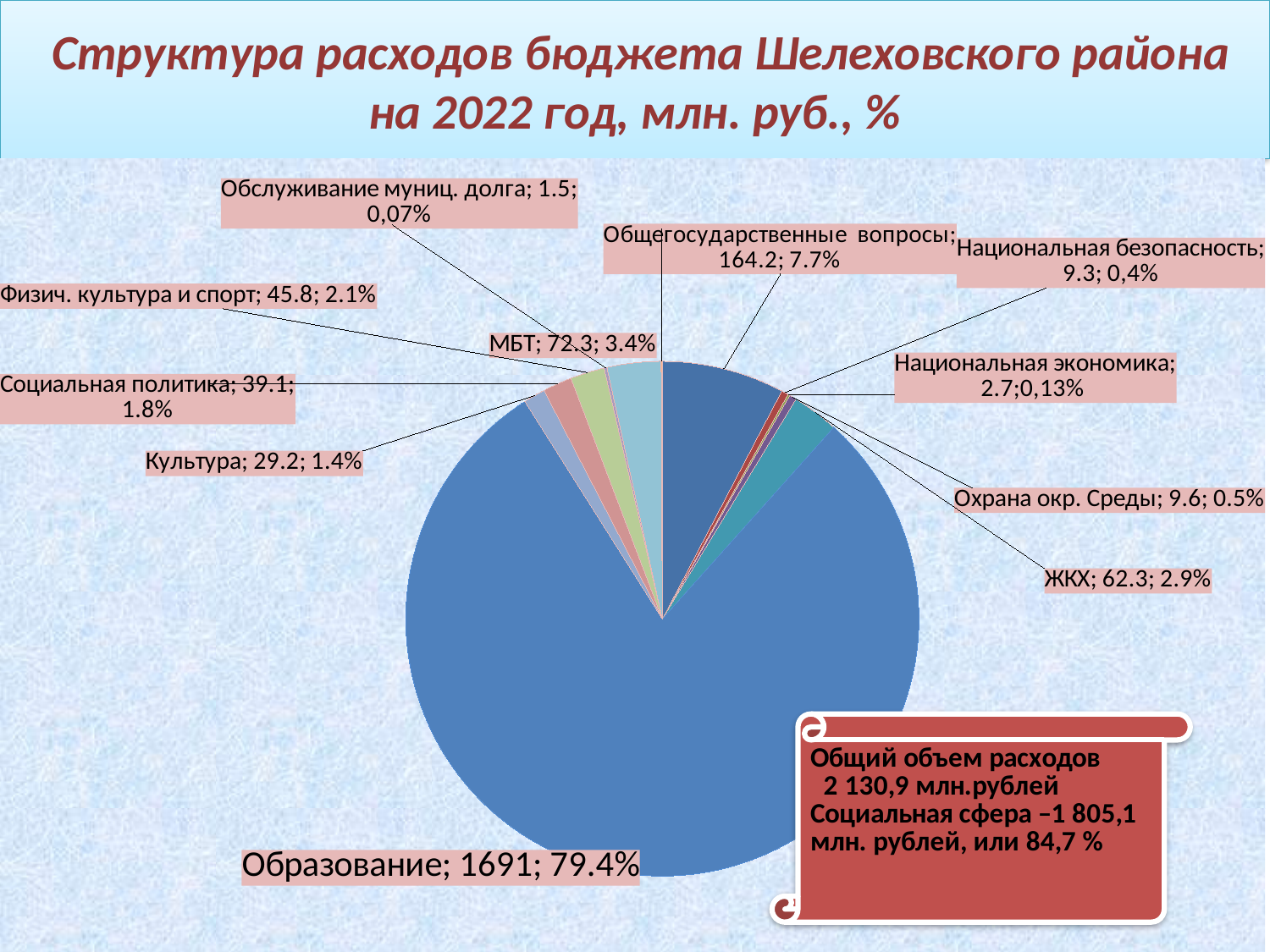
What percentage is shown for Национальная экономика? 0,13% Which category has the smallest value in million rubles? Обслуживание муниц. долга Which is larger in million rubles: Физич. культура и спорт or Социальная политика? Физич. культура и спорт What is the value in million rubles for Общегосударственные вопросы? 164.2 What percentage is shown for МБТ? 3.4% What is the difference in million rubles between Общегосударственные вопросы and ЖКХ? 101.9 What is the value in million rubles for Образование? 1691 What is the value in million rubles for ЖКХ? 62.3 What kind of chart is shown on the slide? pie chart Which category has the largest slice of the pie? Образование What share of the pie does Образование represent? 79.4%